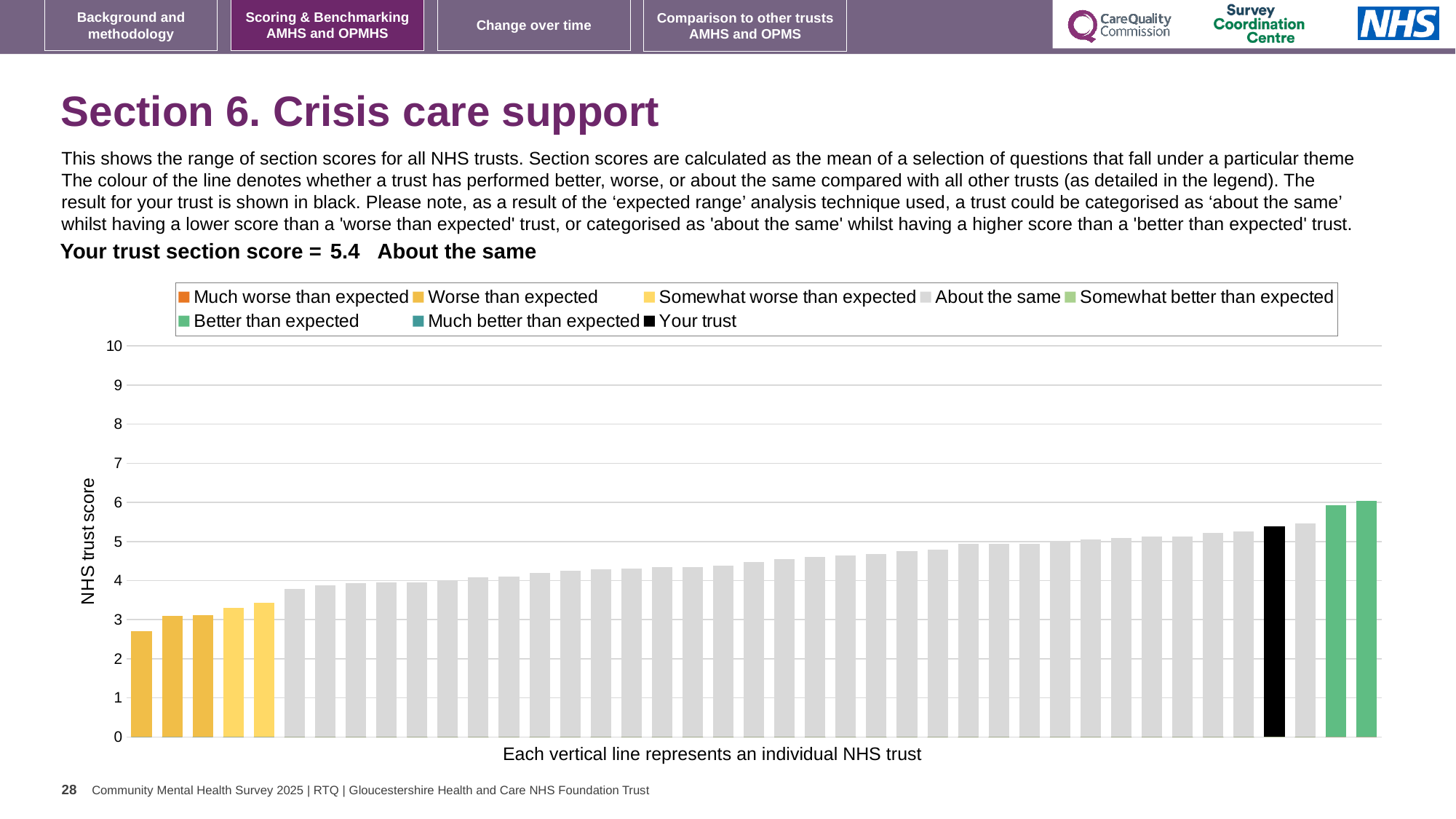
What is the title of the vertical axis? NHS trust score How many entries does the chart legend list? 8 What kind of chart is shown on the slide? Bar chart Do the bar values rise or fall from left to right along the x axis? rise Is the value of the tallest bar greater or less than 7? less What is the section score for your trust, as printed on the slide? 5.4 Is the value of the leftmost (lowest) bar greater or less than 3? less How many green bars are there in the chart? 2 Which category is your trust placed in for this section? About the same Is the value of the black bar (your trust) greater or less than 5? greater What does the label under the horizontal axis say? Each vertical line represents an individual NHS trust Which is taller: the black bar for your trust or the leftmost bar? The black bar for your trust